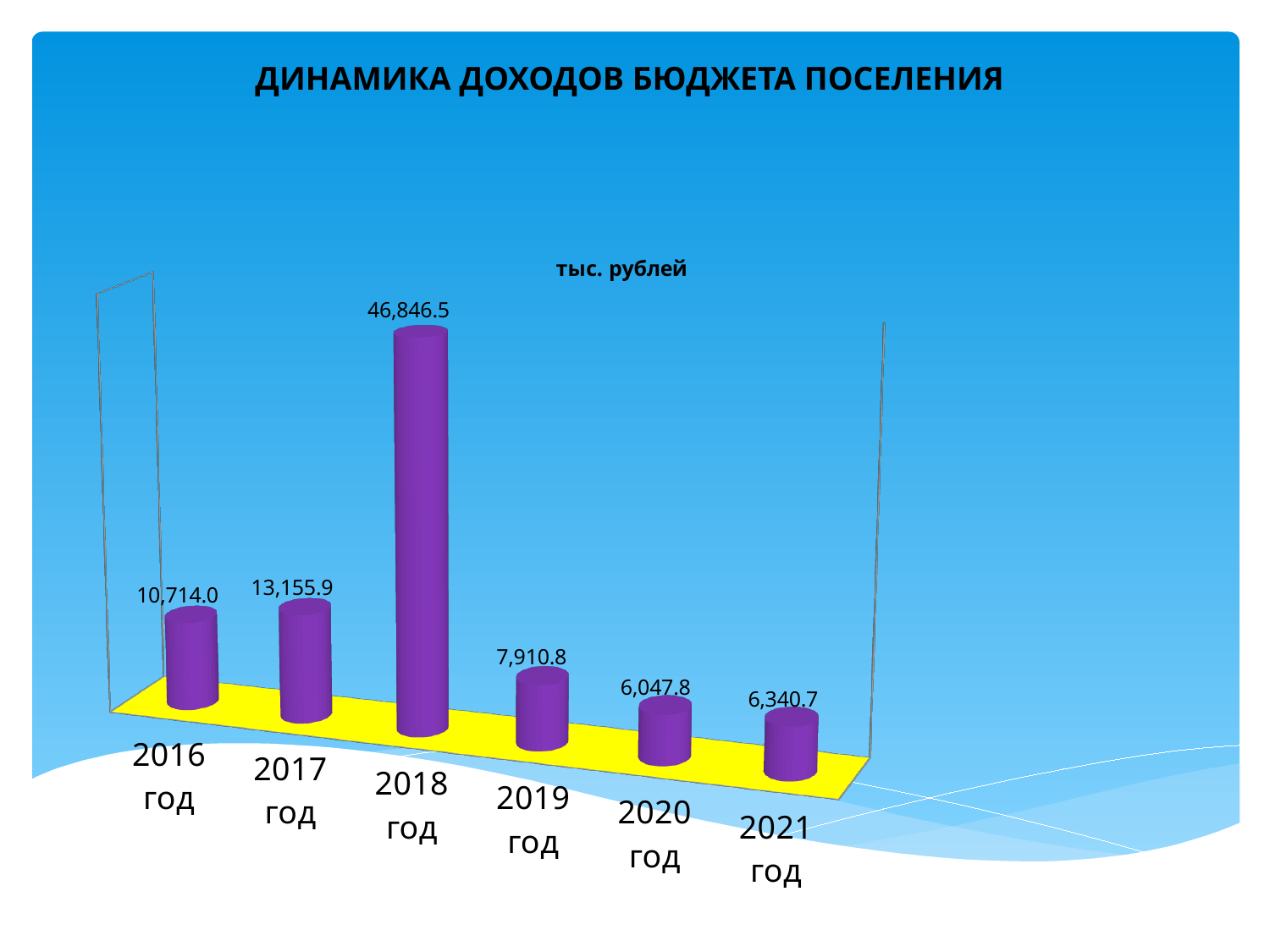
Which year has the lowest value? 2020 год What is the title of the chart? ДИНАМИКА ДОХОДОВ БЮДЖЕТА ПОСЕЛЕНИЯ What is the value for 2016 год? 10,714.0 What is the value for 2021 год? 6,340.7 What is the difference between the values for 2018 год and 2019 год? 38,935.7 What is the value for 2018 год? 46,846.5 How many years are shown on the chart? 6 Which year has the highest value? 2018 год Which is larger, the value for 2020 год or 2021 год? 2021 год What is the difference between the values for 2017 год and 2016 год? 2,441.9 What kind of chart is shown on the slide? Bar chart What is the value for 2020 год? 6,047.8